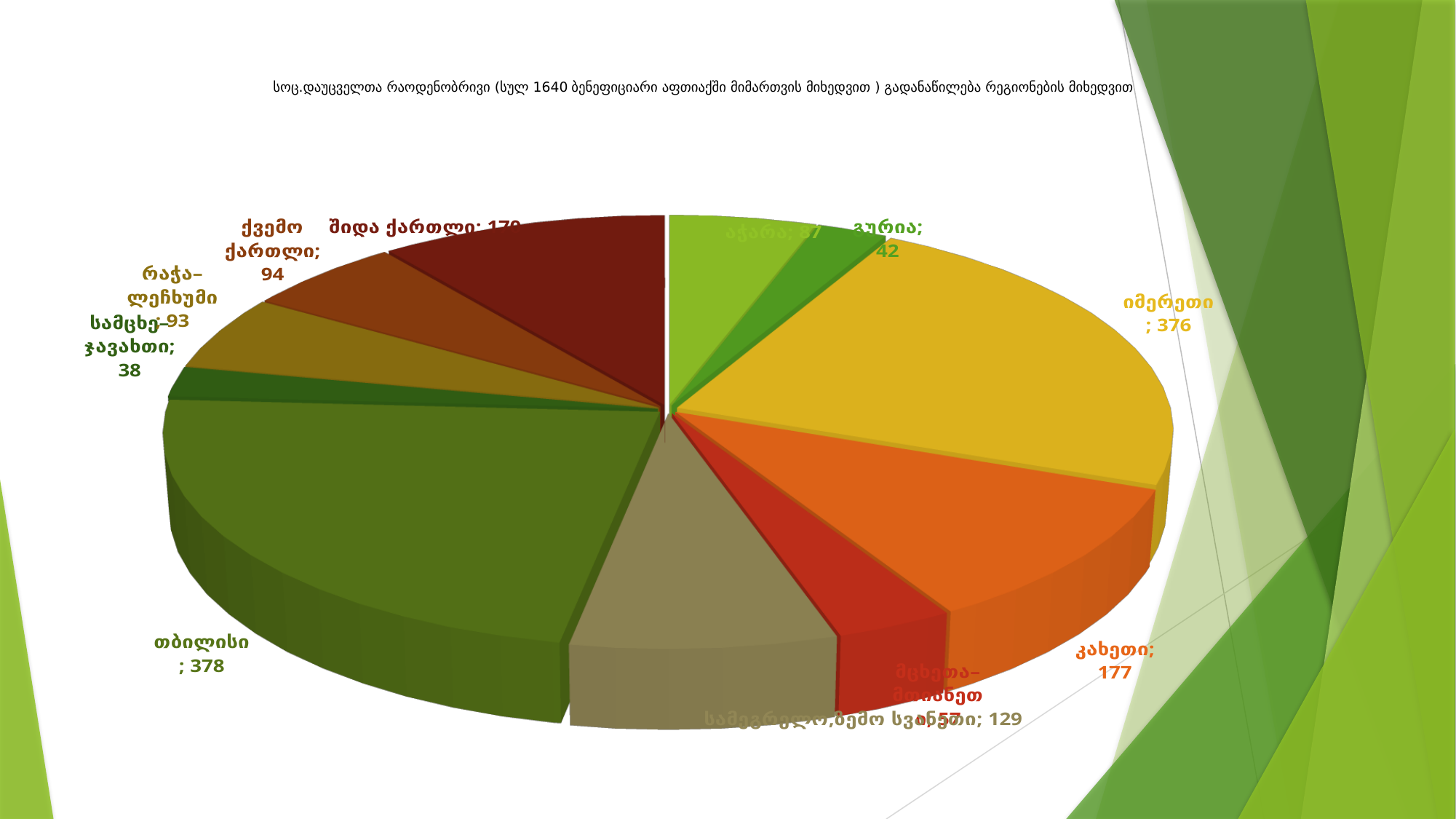
What is the value for სამეგრელო,ზემო სვანეთი? 129 How many slices does the pie chart have? 11 What is the difference between the values for იმერეთი and კახეთი? 199 What is the value for გურია? 42 What is the value for კახეთი? 177 What is the value for ქვემო ქართლი? 94 Which region has the largest value in the pie chart? თბილისი What is the value for იმერეთი? 376 What is the value for თბილისი? 378 Which is larger, the value for კახეთი or the value for სამეგრელო,ზემო სვანეთი? კახეთი Which region has the smallest value in the pie chart? სამცხე–ჯავახთი What kind of chart is shown on the slide? pie chart